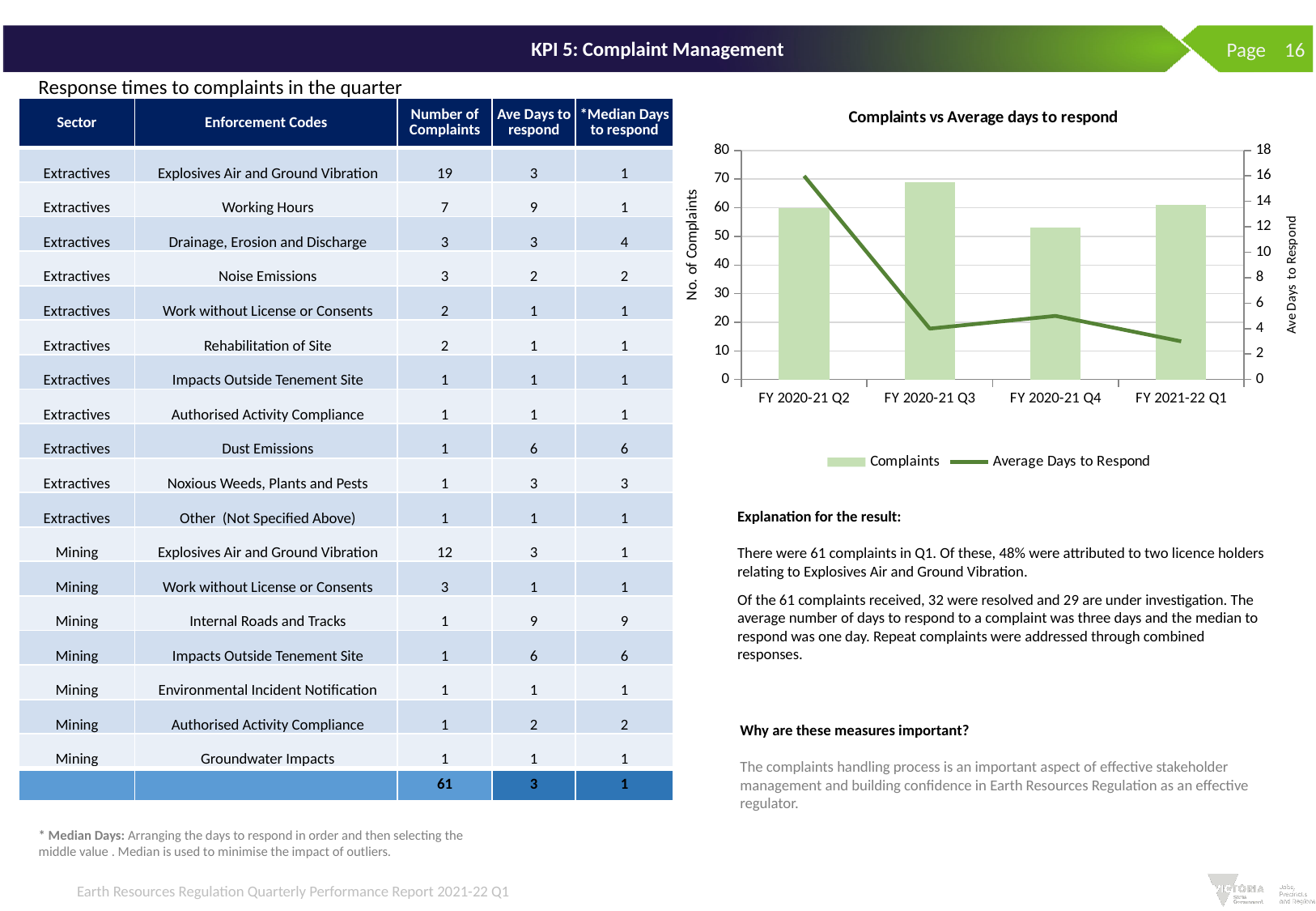
Which quarter has the lowest number of complaints? FY 2020-21 Q4 Is the number of complaints for FY 2020-21 Q4 greater or less than 60? less How many quarters are shown on the x axis of the chart? 4 Which quarter has the highest number of complaints? FY 2020-21 Q3 What is the title of the chart? Complaints vs Average days to respond Is the average days to respond for FY 2020-21 Q2 greater or less than 14? greater Which quarter has the highest average days to respond? FY 2020-21 Q2 Is the number of complaints for FY 2020-21 Q3 greater or less than 60? greater Which has more complaints, FY 2020-21 Q3 or FY 2020-21 Q4? FY 2020-21 Q3 How many series does the chart legend list? 2 Does the average days to respond rise or fall from FY 2020-21 Q2 to FY 2020-21 Q3? Fall What kind of chart is shown on the slide? A combined bar and line chart